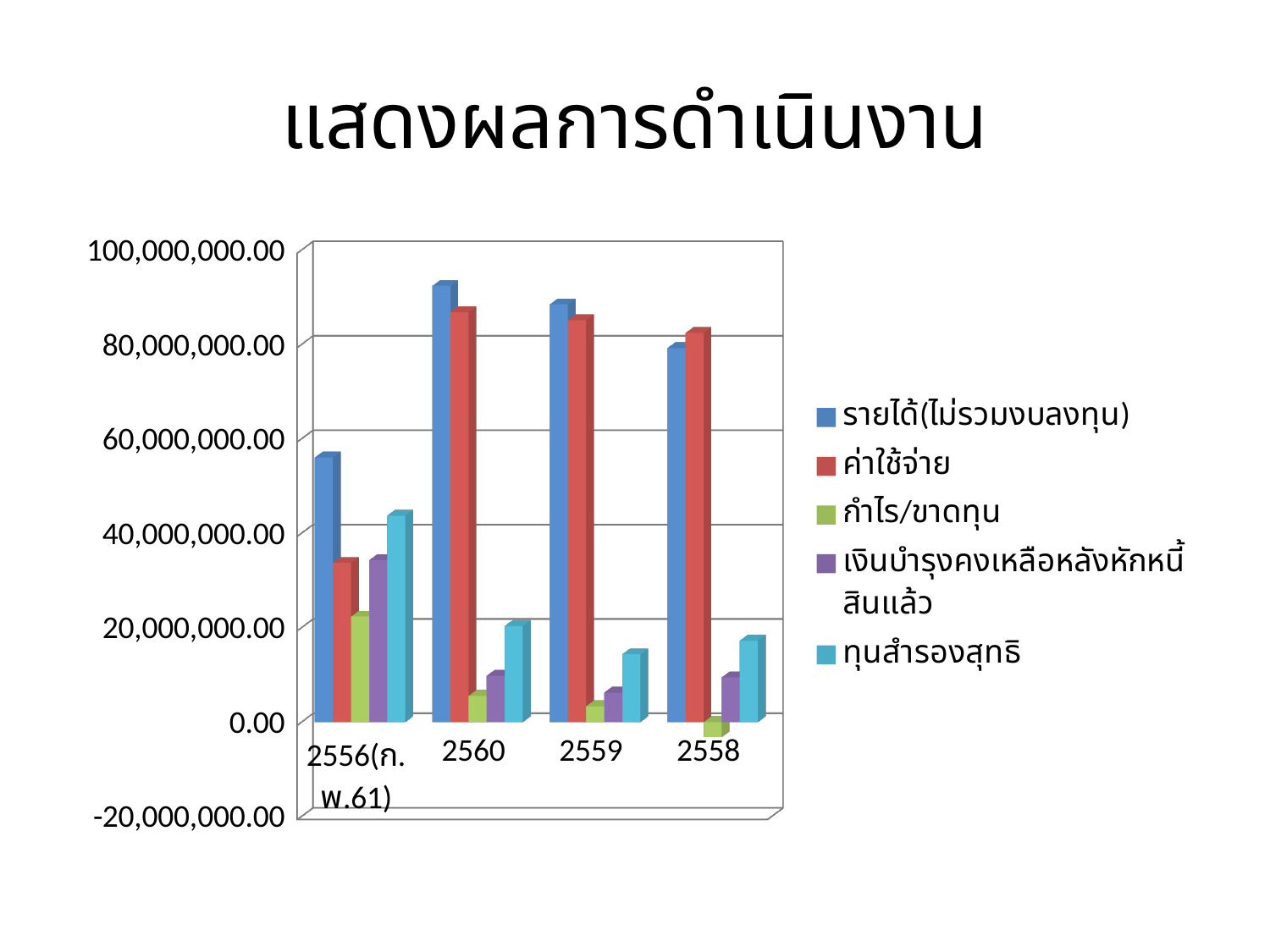
Which is larger: กำไร/ขาดทุน in 2556(ก.พ.61) or กำไร/ขาดทุน in 2560? 2556(ก.พ.61) What is the title of the chart on the slide? แสดงผลการดำเนินงาน In which category is the value for รายได้(ไม่รวมงบลงทุน) the highest? 2560 Which series is shown in green in the chart legend? กำไร/ขาดทุน In 2560, which is larger: รายได้(ไม่รวมงบลงทุน) or ค่าใช้จ่าย? รายได้(ไม่รวมงบลงทุน) Is the value for รายได้(ไม่รวมงบลงทุน) in 2556(ก.พ.61) greater or less than 60,000,000.00? less What kind of chart is shown on the slide? bar chart In which category is the value for กำไร/ขาดทุน the lowest? 2558 Is the value for รายได้(ไม่รวมงบลงทุน) in 2560 greater or less than 80,000,000.00? greater How many series does the chart legend list? 5 How many categories are shown on the x axis of the chart? 4 Is the value for กำไร/ขาดทุน in 2558 greater or less than 0.00? less